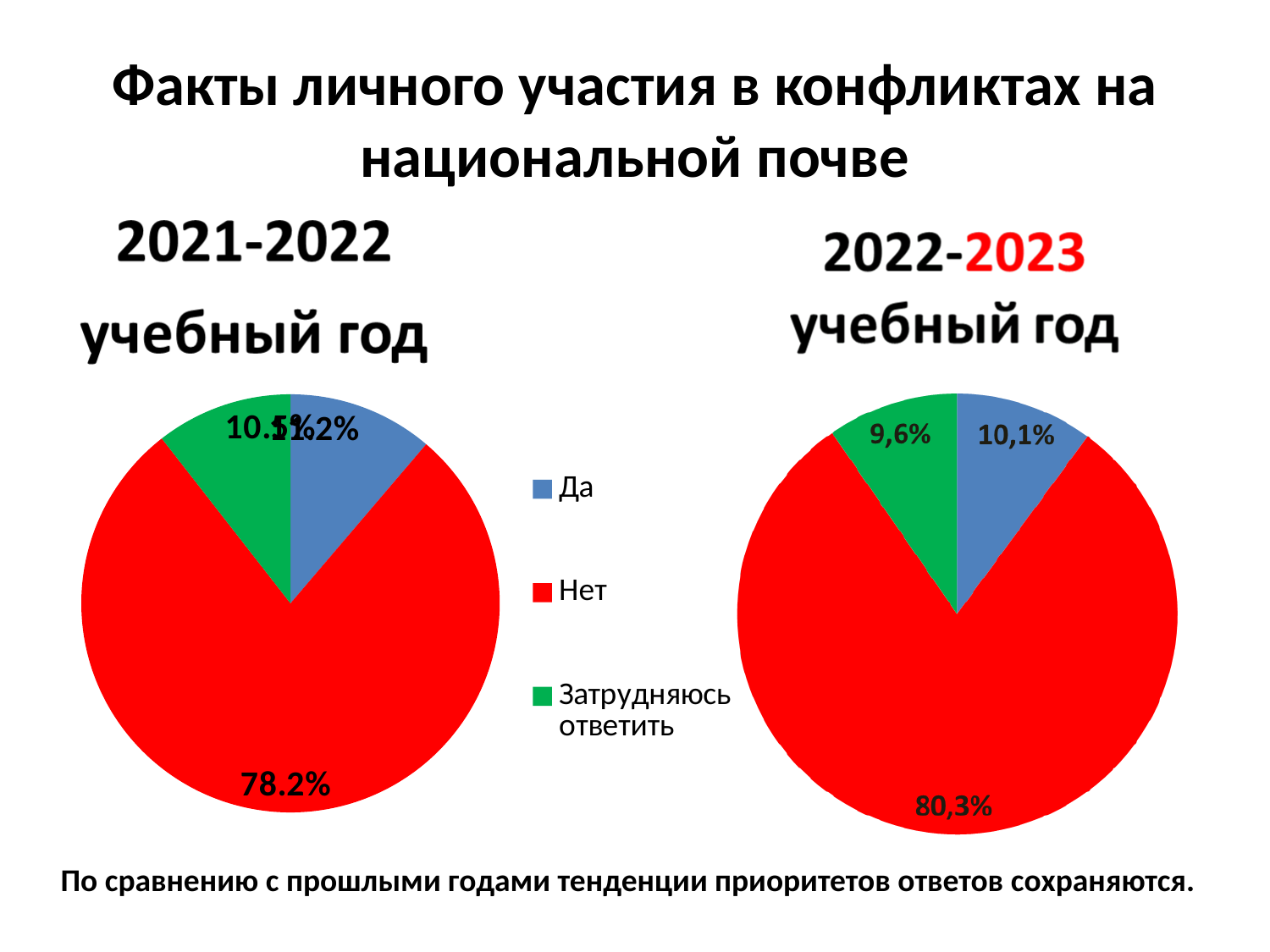
In the 2022-2023 учебный год pie chart, what percentage is shown for Затрудняюсь ответить? 9,6% In the 2022-2023 учебный год pie chart, what is the difference between the shares for Нет and Да? 70,2% In the 2021-2022 учебный год pie chart, which answer has the largest share? Нет What type of chart is used on this slide for the 2021-2022 and 2022-2023 data? Pie chart In the 2022-2023 учебный год pie chart, which answer has the smallest share? Затрудняюсь ответить How many entries does the legend list? 3 Which chart shows a larger share for Нет, the 2021-2022 учебный год chart or the 2022-2023 учебный год chart? 2022-2023 учебный год What colour represents Нет in the pie charts? Red In the 2022-2023 учебный год pie chart, what percentage is shown for Да? 10,1% In the 2022-2023 учебный год pie chart, what percentage is shown for Нет? 80,3% In the 2021-2022 учебный год pie chart, what percentage is shown for Нет? 78.2% How many slices does the 2022-2023 учебный год pie chart have? 3